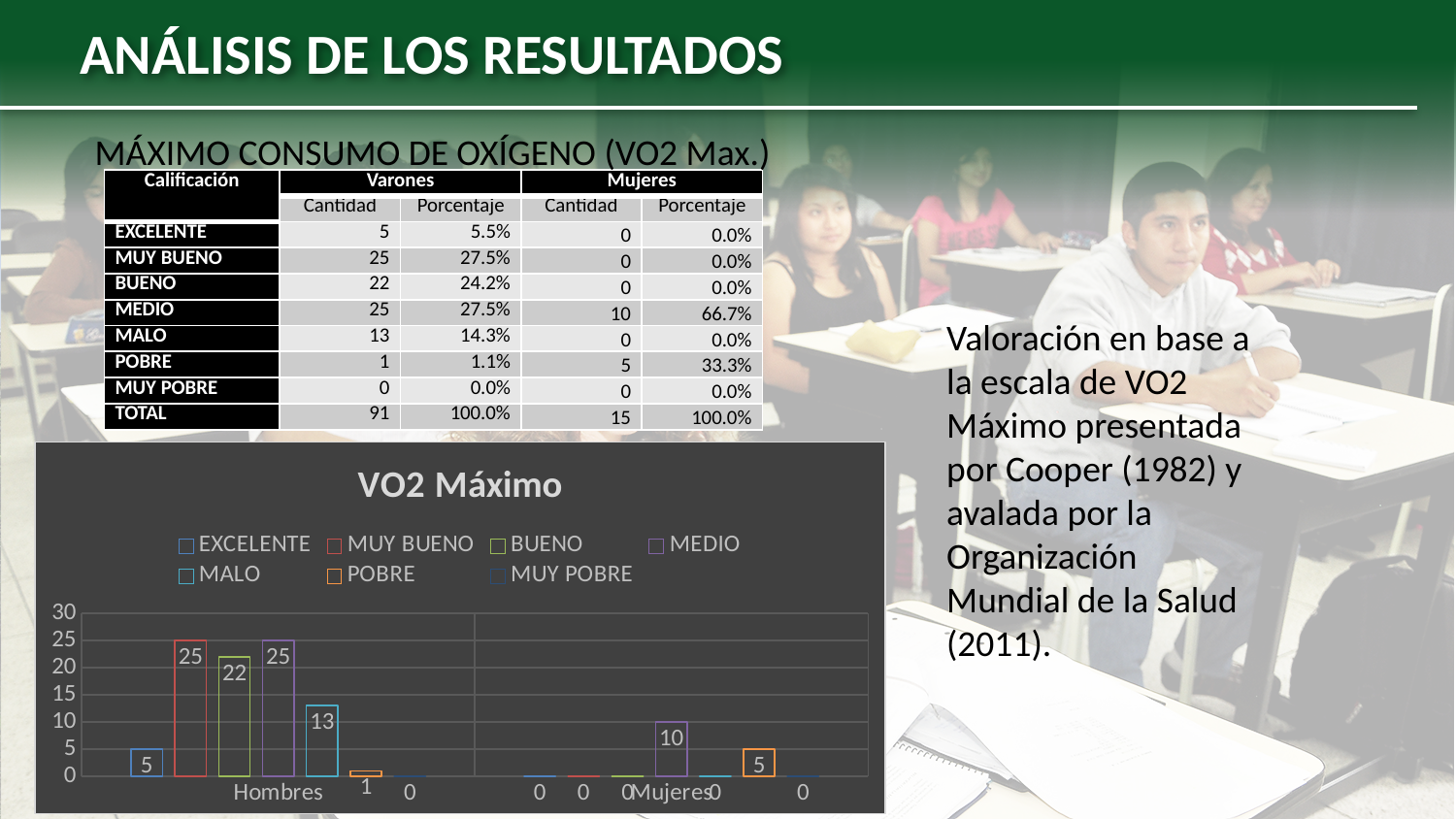
What is the value for MALO in the Hombres category? 13 Which series has the lowest value in the Hombres category? MUY POBRE What is the difference between the MEDIO values for Hombres and Mujeres? 15 What type of chart is shown on the slide? bar chart How many series does the chart legend list? 7 What is the value for MEDIO in the Hombres category? 25 Which is larger: the EXCELENTE value for Hombres or the MEDIO value for Mujeres? MEDIO value for Mujeres What is the title of the chart on the slide? VO2 Máximo What is the value for BUENO in the Hombres category? 22 What is the value for MEDIO in the Mujeres category? 10 How many categories are shown on the x axis of the chart? 2 What is the value for POBRE in the Mujeres category? 5